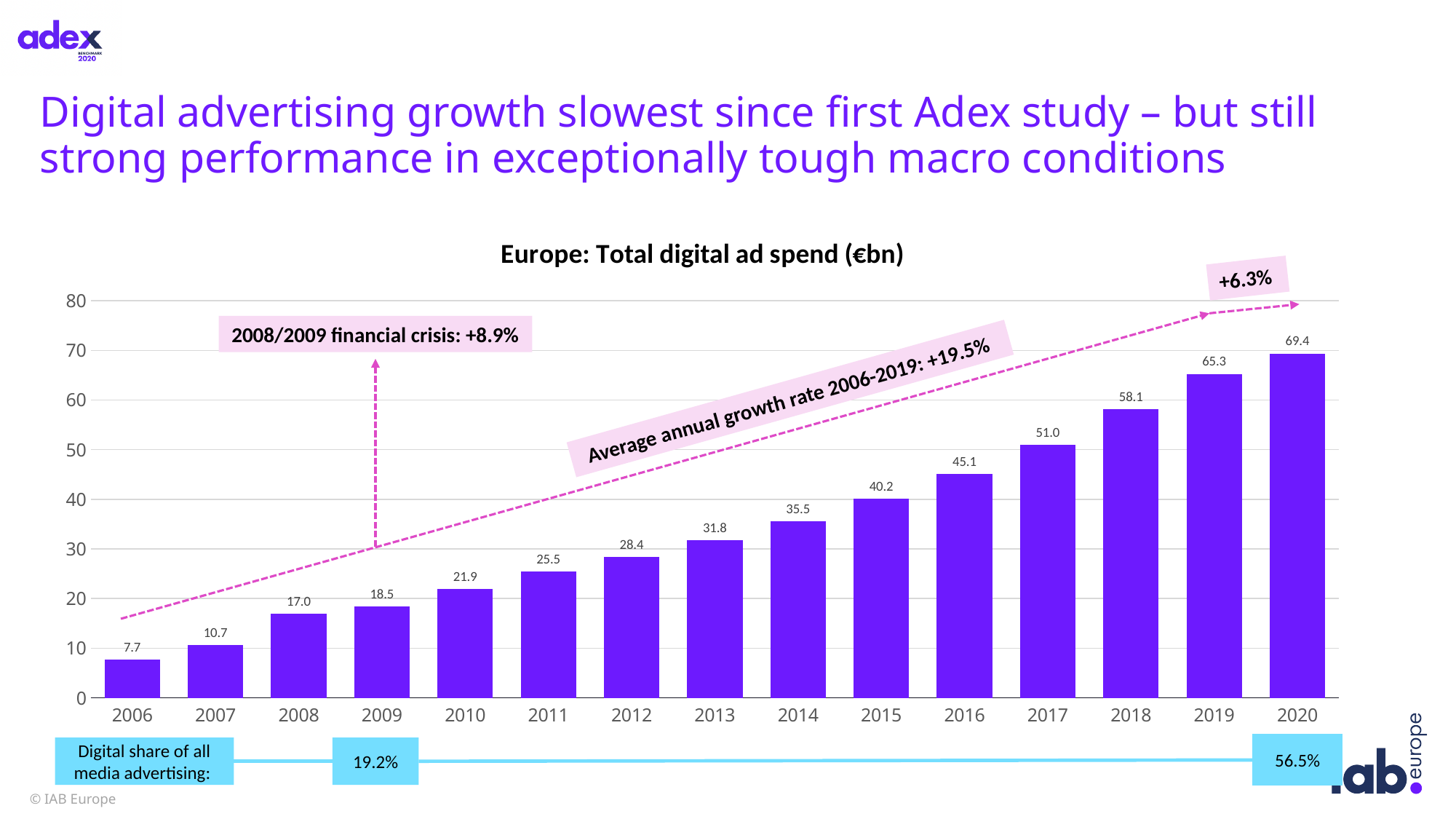
What is the title of the chart? Europe: Total digital ad spend (€bn) How many years are shown on the x axis of the chart? 15 Which year has a larger digital ad spend, 2012 or 2015? 2015 What is the difference in digital ad spend between 2020 and 2019? 4.1 What is the total digital ad spend for 2009? 18.5 What is the total digital ad spend for 2020? 69.4 What kind of chart is used to show total digital ad spend? Bar chart What is the total digital ad spend for 2014? 35.5 Which year has the lowest total digital ad spend? 2006 What is the difference in digital ad spend between 2018 and 2017? 7.1 Do the digital ad spend values rise or fall from 2006 to 2020? Rise Which year has the highest total digital ad spend? 2020